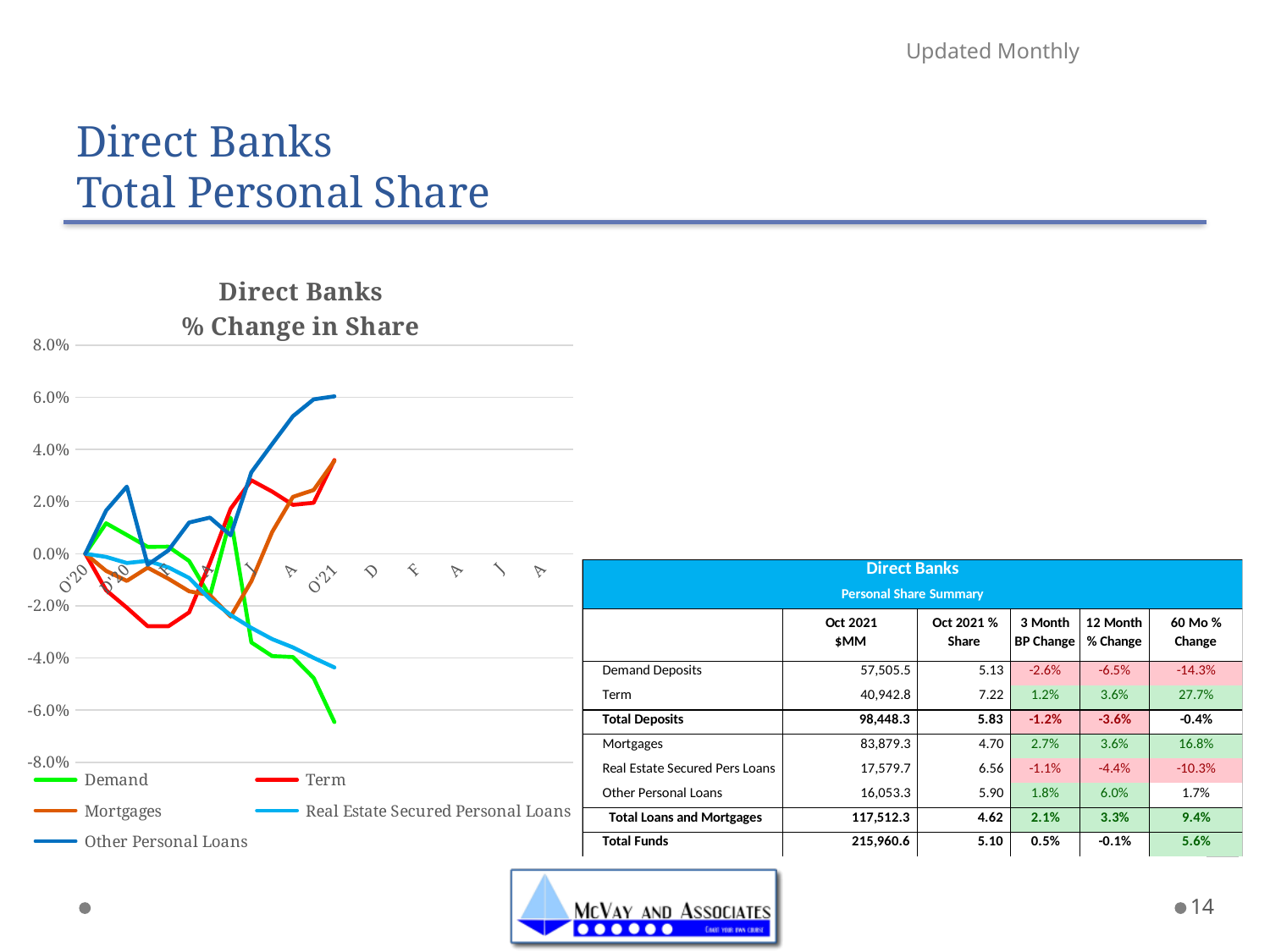
Which series has the highest value at O'21 in the "Direct Banks % Change in Share" chart? Other Personal Loans Does the Demand line rise or fall over the months leading up to O'21? fall What colour is the Demand line in the "Direct Banks % Change in Share" chart? green What kind of chart is the "Direct Banks % Change in Share" chart? line chart Is the value for Real Estate Secured Personal Loans at O'21 greater or less than -2.0%? less How many series does the legend of the "Direct Banks % Change in Share" chart list? 5 Is the value for Other Personal Loans at O'21 greater or less than 4.0%? greater Is the value for Mortgages at O'21 greater or less than 2.0%? greater What is the title of the chart on the slide? Direct Banks % Change in Share Which series has the lowest value at O'21 in the "Direct Banks % Change in Share" chart? Demand At O'21, which is larger: the value for Term or the value for Demand? Term